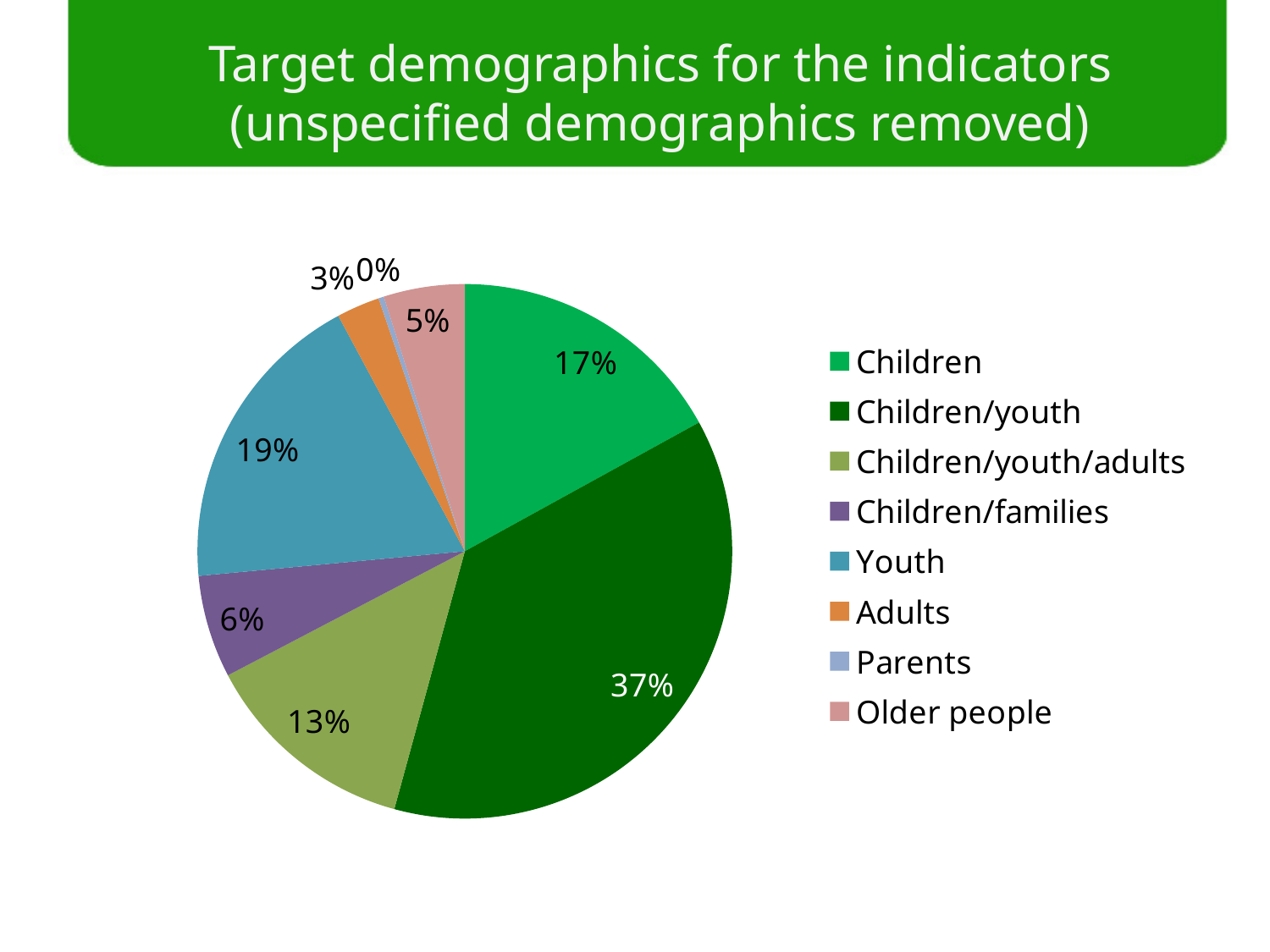
How many categories does the legend list? 8 What share of the pie does Older people have? 5% Which is larger, the share for Youth or the share for Children/youth/adults? Youth What is the difference between the shares for Children/youth and Children? 20% Which category has the smallest slice of the pie? Parents What colour is the Adults slice? orange What is the title of the chart? Target demographics for the indicators (unspecified demographics removed) What share of the pie does Youth have? 19% What share of the pie does Children/youth have? 37% What share of the pie does Children/families have? 6% Which category has the largest slice of the pie? Children/youth What kind of chart is shown on the slide? pie chart